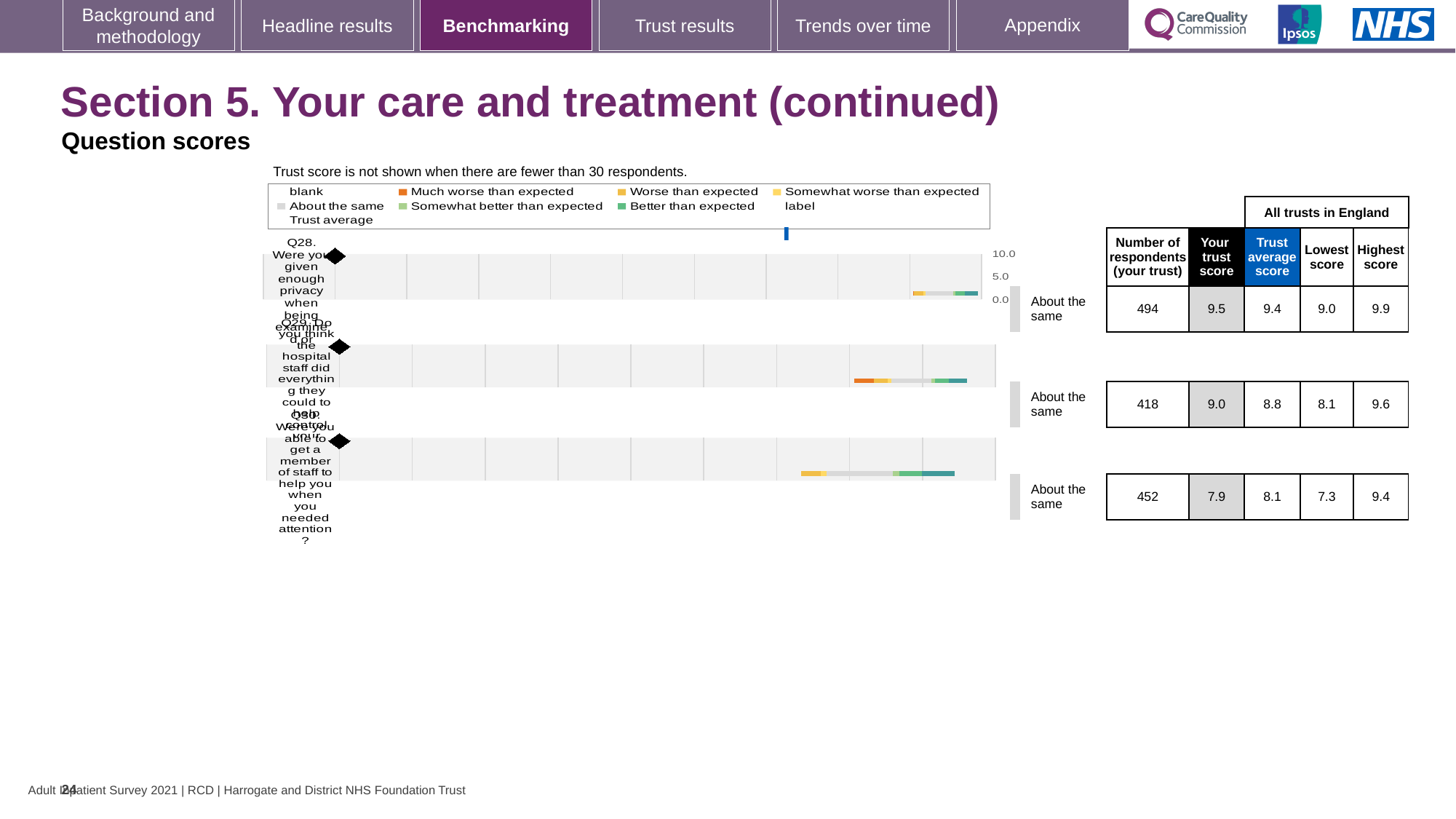
Which question has the highest 'Your trust score'? Q28 What is the maximum value shown on the chart's score axis? 10.0 How many respondents does the table show for Q30? 452 For Q30, which is larger: 'Your trust score' or the 'Trust average score'? Trust average score How many respondents does the table show for Q29? 418 What is the 'Trust average score' for Q29? 8.8 What is the 'Your trust score' value for Q28? 9.5 What is the difference between the highest score and the lowest score for Q29? 1.5 What benchmark category is shown for Q28? About the same How many questions are plotted in the question scores chart? 3 Which question has the lowest 'Your trust score'? Q30 What kind of chart is used to show the question scores on this slide? bar chart